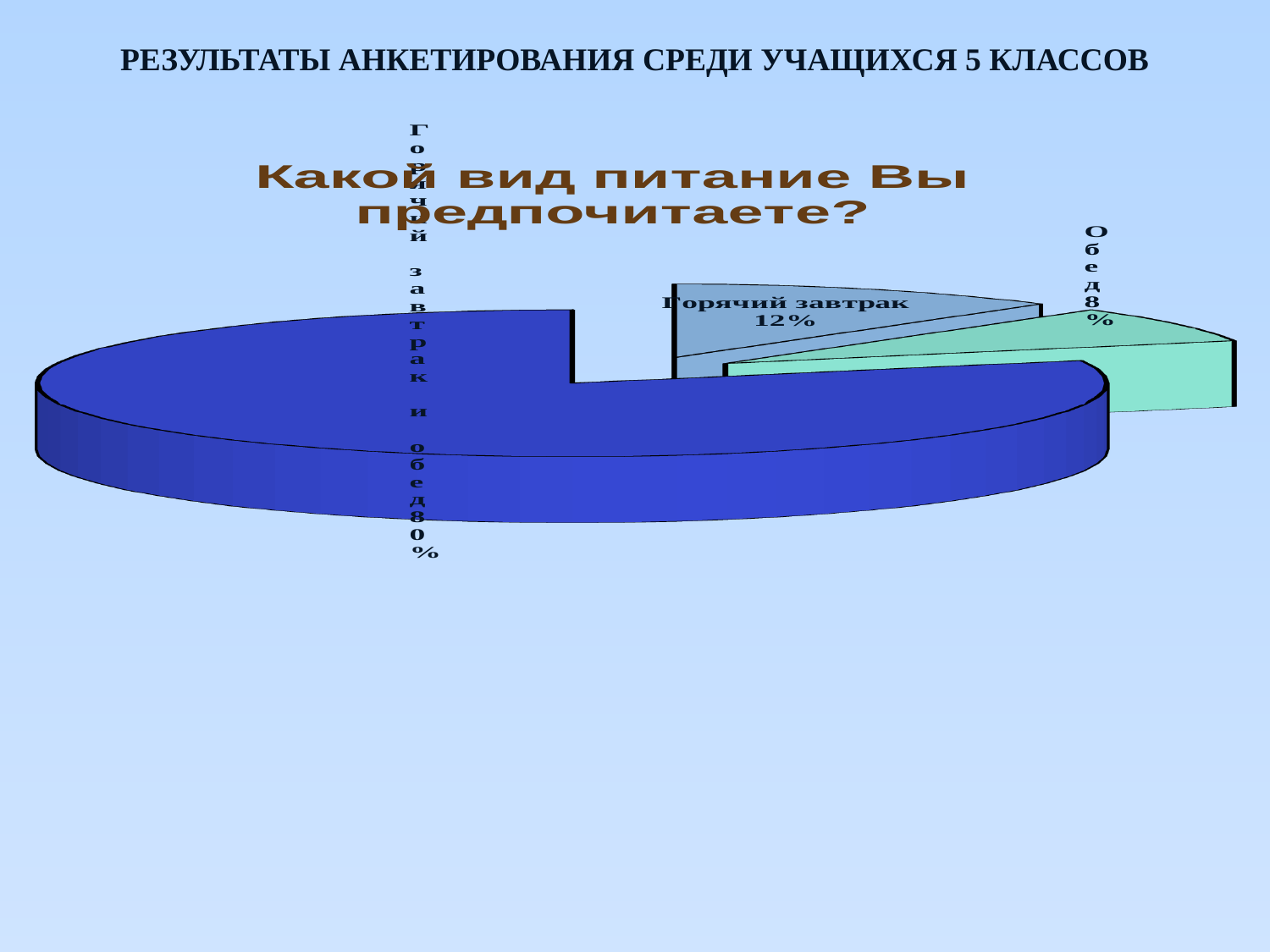
How many slices does the pie chart have? 3 What share of the pie is labelled "Горячий завтрак"? 12% What kind of chart is shown on the slide? Pie chart What is the title of the chart? Какой вид питание Вы предпочитаете? What share of the pie is labelled "Горячий завтрак и обед"? 80% What is the difference in percentage points between the "Горячий завтрак" slice and the "Обед" slice? 4 Which slice of the pie is the smallest? Обед Which slice of the pie is the largest? Горячий завтрак и обед Which is larger, the share for "Горячий завтрак" or the share for "Обед"? Горячий завтрак What share of the pie is labelled "Обед"? 8% What is the difference in percentage points between the "Горячий завтрак и обед" slice and the "Горячий завтрак" slice? 68 What colour is the largest slice of the pie? Blue